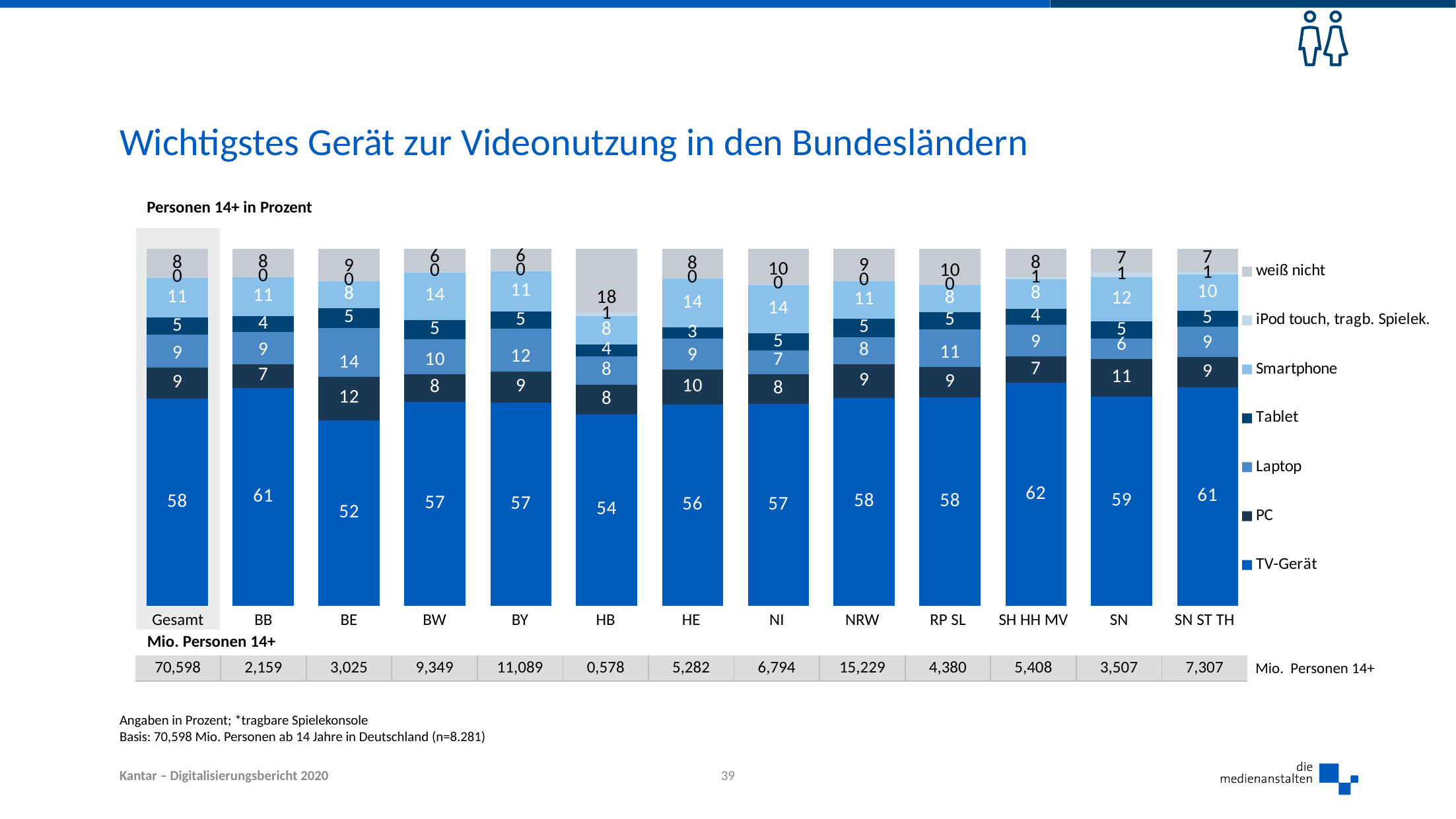
What is the weiß nicht value for HB? 18 What type of chart is shown on the slide? stacked bar chart Which category has the highest TV-Gerät value? SH HH MV Which is larger, the Laptop value for BE or the Laptop value for SN? BE What is the Smartphone value for HE? 14 What is the difference between the TV-Gerät values for SH HH MV and BE? 10 What is the TV-Gerät value for BE? 52 Which category has the lowest TV-Gerät value? BE What is the Mio. Personen 14+ figure shown for NRW? 15,229 How many series does the legend list? 7 How many categories (bars) are shown along the x axis? 13 What is the title of the chart? Wichtigstes Gerät zur Videonutzung in den Bundesländern